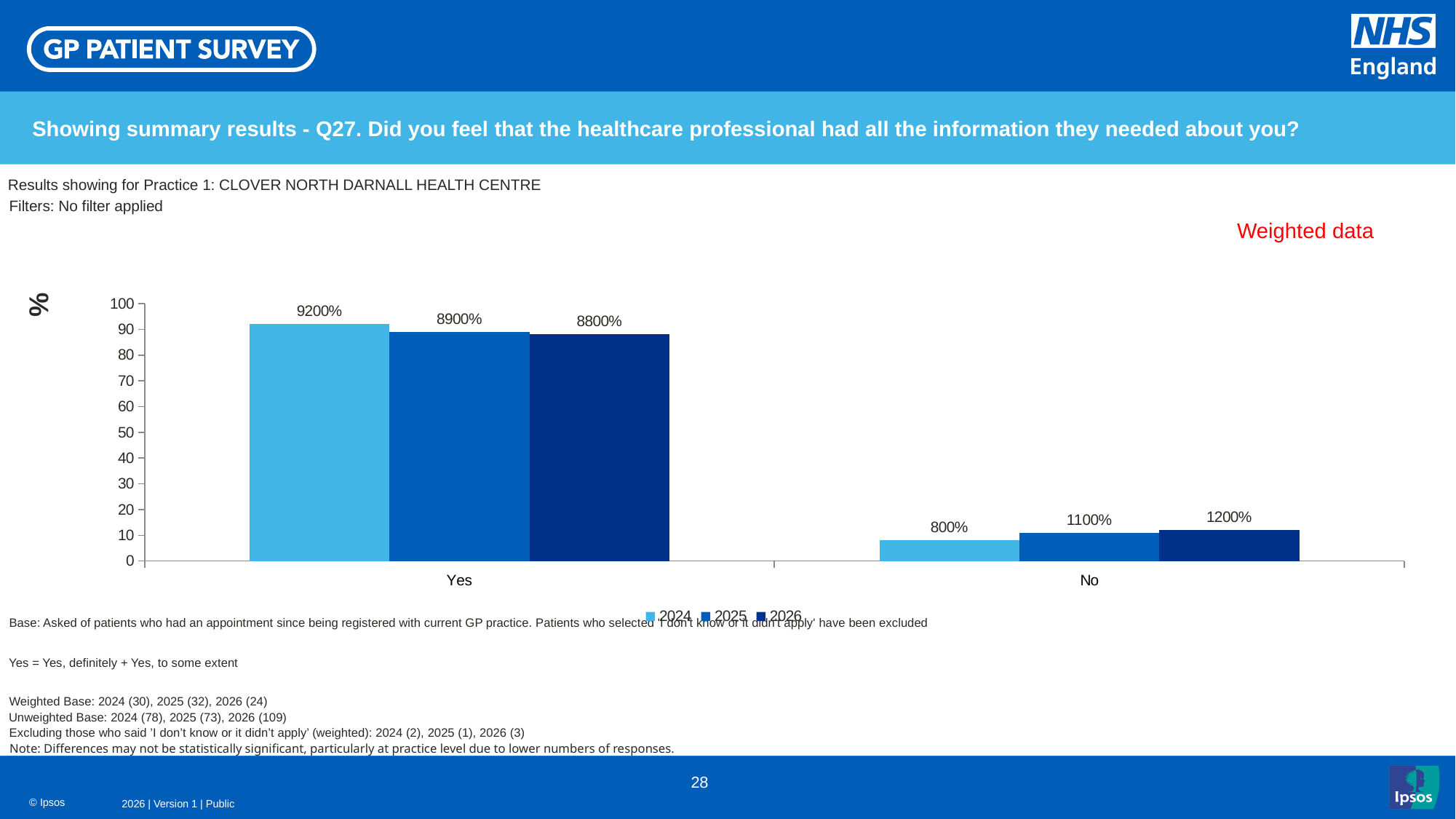
Which year has the tallest bar in the Yes category? 2024 What is the data label shown for the 2024 bar in the No category? 800% What type of chart is shown on the slide? bar chart How many response categories are shown on the x axis? 2 What is the data label shown for the 2026 bar in the No category? 1200% How many series does the legend list? 3 What is the data label shown for the 2024 bar in the Yes category? 9200% Is the 2026 bar in the No category above or below the 10 mark on the y axis? above What is the data label shown for the 2025 bar in the Yes category? 8900% Is the 2025 bar in the Yes category taller or shorter than the 2026 bar in the Yes category? taller Which year has the shortest bar in the No category? 2024 Across the years 2024, 2025 and 2026, do the bars in the No category rise or fall? rise